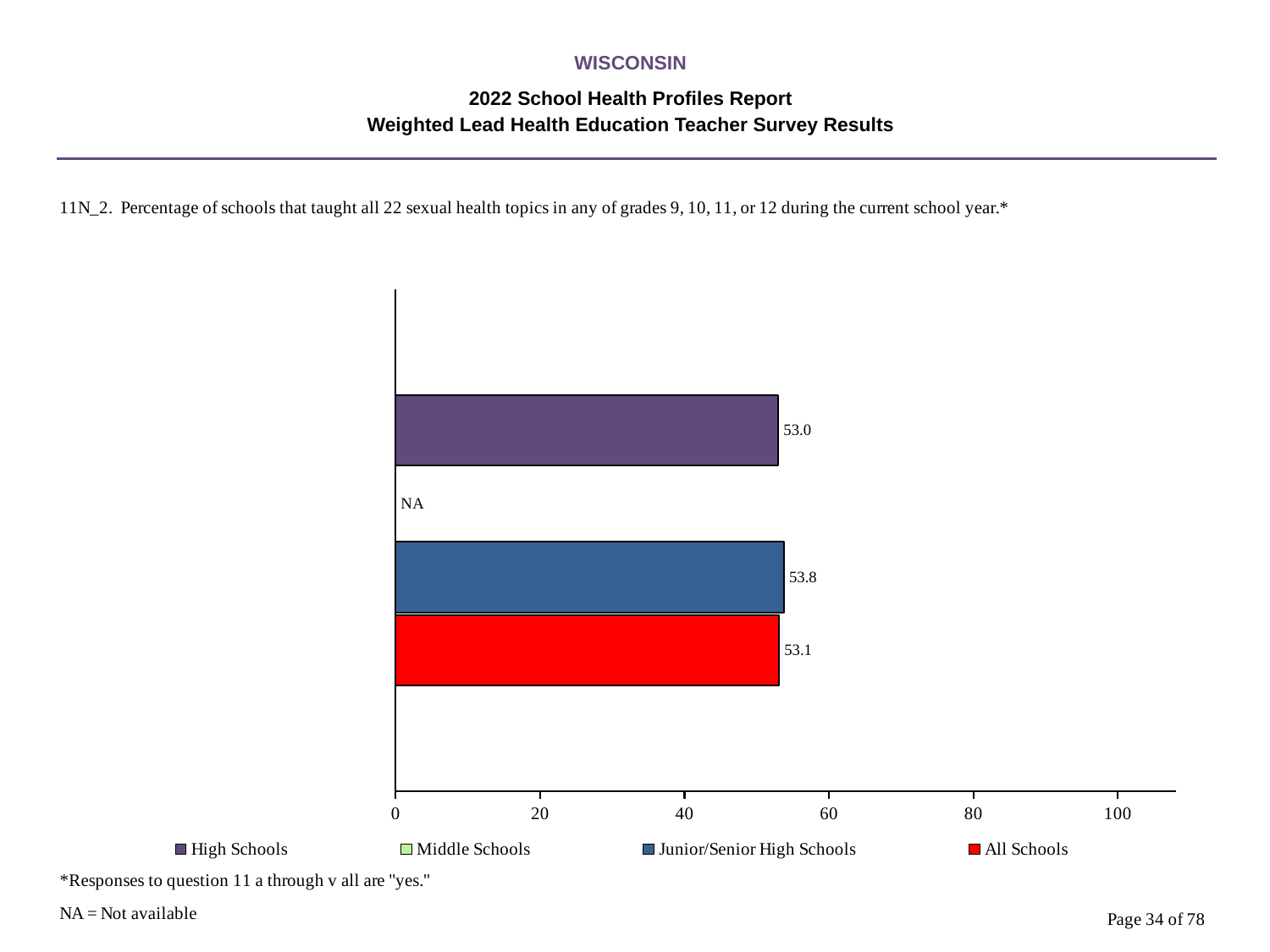
What colour is the bar for All Schools? red Is the value for All Schools greater or less than 60? less What is the value for High Schools? 53.0 How many series does the legend list? 4 What is the difference between the values for All Schools and High Schools? 0.1 What kind of chart is shown? bar chart What is shown for Middle Schools? NA What is the value for All Schools? 53.1 Which group has the highest value according to the data labels? Junior/Senior High Schools What is the difference between the values for Junior/Senior High Schools and High Schools? 0.8 What is the value for Junior/Senior High Schools? 53.8 Is the value for High Schools greater or less than 40? greater